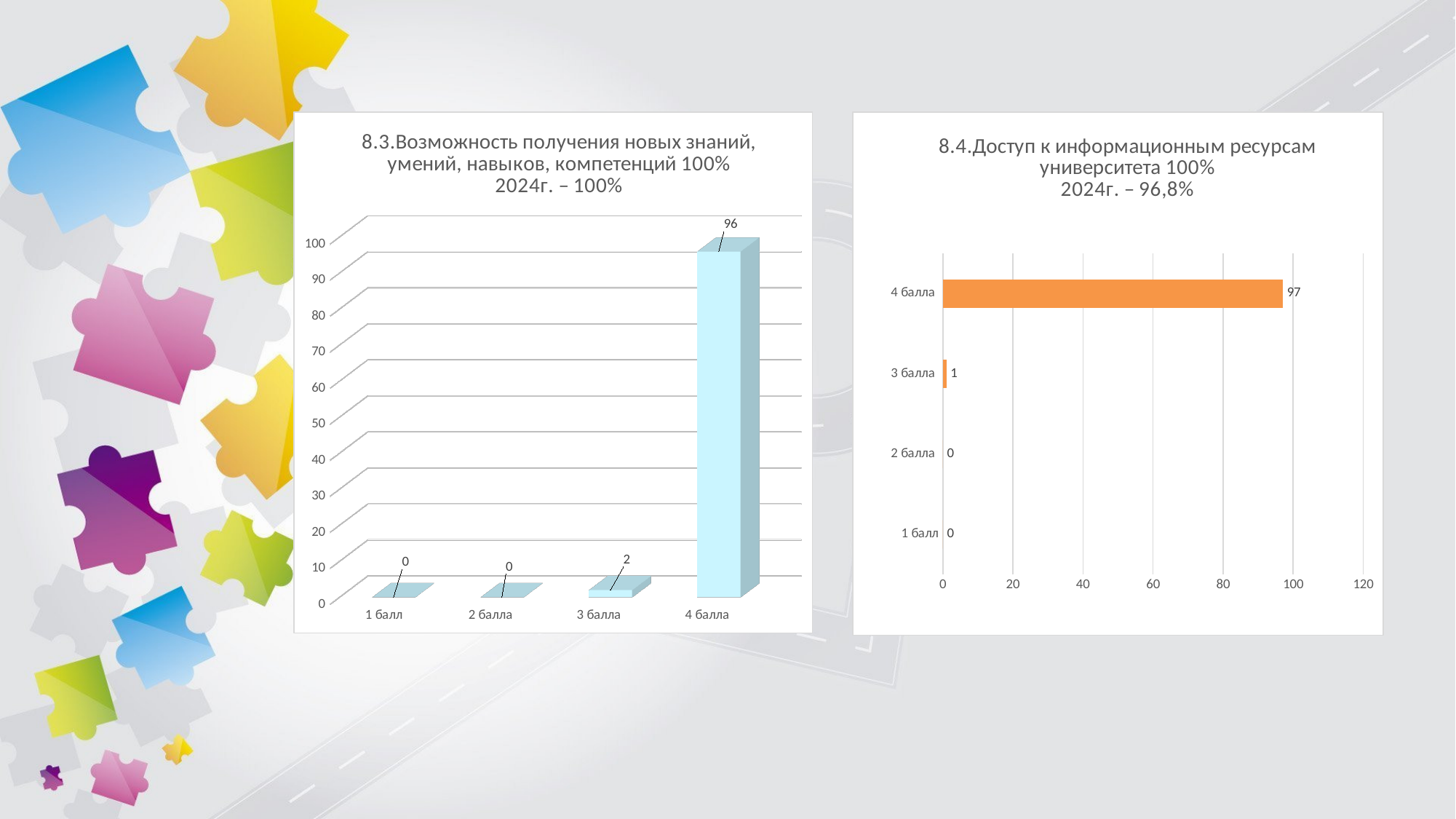
In the left chart (8.3), which category has the highest value? 4 балла In the left chart (8.3), what is the value for 3 балла? 2 In the right chart (8.4), what is the difference between the values for 4 балла and 3 балла? 96 In the left chart (8.3), what is the value for 4 балла? 96 In the left chart (8.3), how many categories are shown on the x axis? 4 In the left chart (8.3), what kind of chart is shown? Bar chart In the left chart (8.3), what is the difference between the values for 4 балла and 3 балла? 94 In the right chart (8.4), what is the value for 3 балла? 1 In the right chart (8.4), which category has the highest value? 4 балла In the right chart (8.4), what is the value for 2 балла? 0 In the right chart (8.4), what is the value for 4 балла? 97 In the right chart (8.4), what is the highest value shown on the horizontal axis? 120